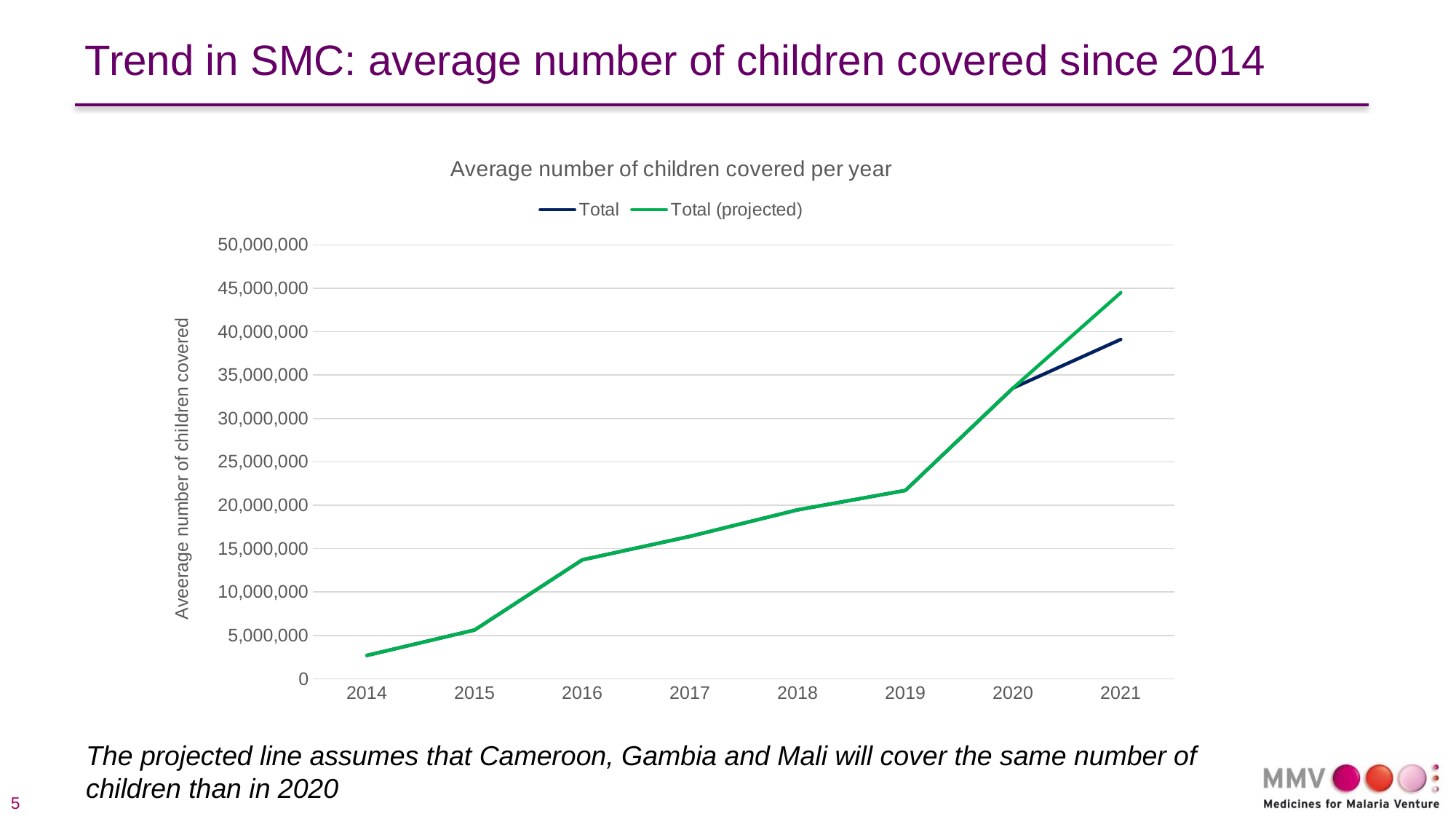
Do the values rise or fall from 2014 to 2021? Rise Is the value for 2020 greater or less than 30,000,000? greater Which year has the highest value on the chart? 2021 Is the value for 2014 greater or less than 5,000,000? less Is the value for 2016 greater or less than 10,000,000? greater How many series does the chart legend list? 2 What kind of chart is shown on the slide? Line chart What is the title of the chart? Average number of children covered per year In 2021, which series has the larger value, Total or Total (projected)? Total (projected) Which year has the lowest average number of children covered? 2014 How many years are shown on the x axis of the chart? 8